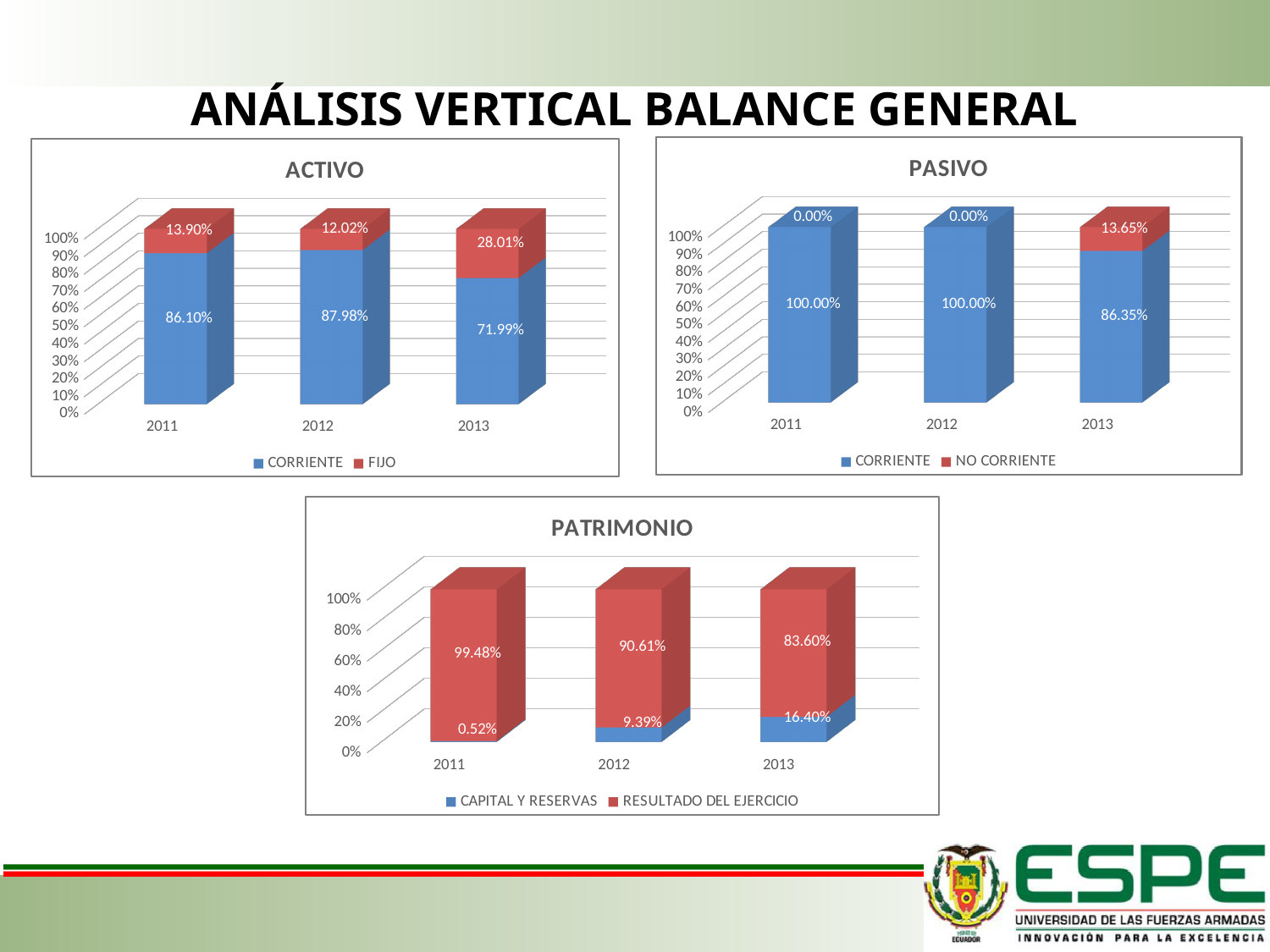
How many series does the legend of the PASIVO chart list? 2 In the ACTIVO chart, what is the value for CORRIENTE in 2011? 86.10% In the PATRIMONIO chart, what is the value for RESULTADO DEL EJERCICIO in 2013? 83.60% In the PASIVO chart, what is the value for NO CORRIENTE in 2013? 13.65% In the PASIVO chart, which year has the lowest CORRIENTE value? 2013 In the PATRIMONIO chart, does the CAPITAL Y RESERVAS value rise or fall from 2011 to 2013? rise In the PATRIMONIO chart, which is larger in 2011: CAPITAL Y RESERVAS or RESULTADO DEL EJERCICIO? RESULTADO DEL EJERCICIO In the PATRIMONIO chart, what is the value for CAPITAL Y RESERVAS in 2012? 9.39% In the PASIVO chart, what is the value for CORRIENTE in 2012? 100.00% In the ACTIVO chart, what is the value for FIJO in 2013? 28.01% In the ACTIVO chart, which year has the highest FIJO value? 2013 In the ACTIVO chart, what is the difference between the CORRIENTE values for 2012 and 2013? 15.99%